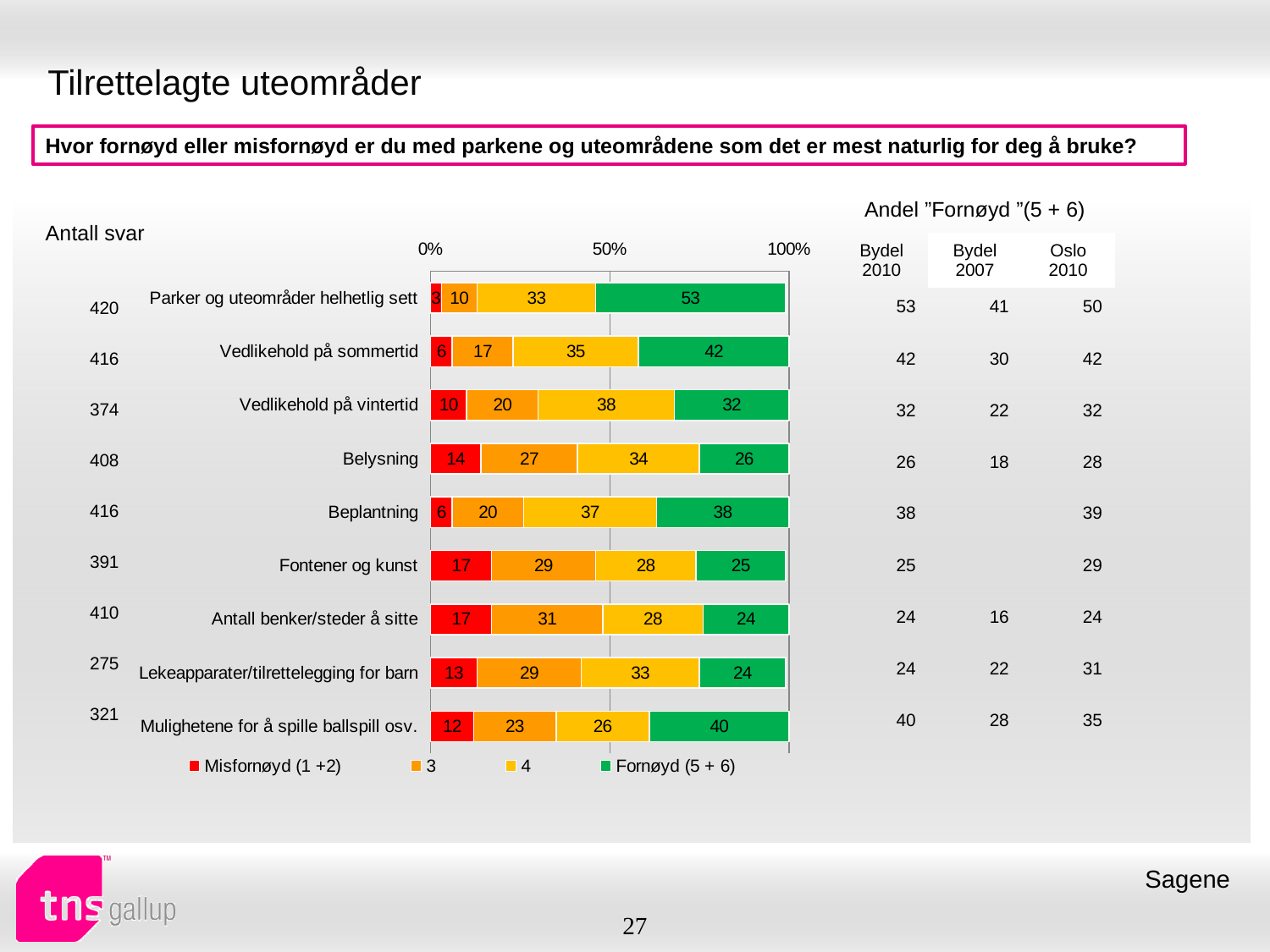
What is the value of series 3 for Antall benker/steder å sitte? 31 What kind of chart is shown on the slide? stacked bar chart What is the value of series 4 for Vedlikehold på vintertid? 38 How many series does the chart legend list? 4 How many categories are plotted in the chart? 9 Which has a larger Fornøyd (5 + 6) value, Beplantning or Fontener og kunst? Beplantning What is the Misfornøyd (1 +2) value for Belysning? 14 What is the name of the last series in the legend? Fornøyd (5 + 6) What is the Fornøyd (5 + 6) value for Parker og uteområder helhetlig sett? 53 What is the difference between the Fornøyd (5 + 6) values for Vedlikehold på sommertid and Vedlikehold på vintertid? 10 Which category has the highest Fornøyd (5 + 6) value? Parker og uteområder helhetlig sett Which category has the lowest Misfornøyd (1 +2) value? Parker og uteområder helhetlig sett